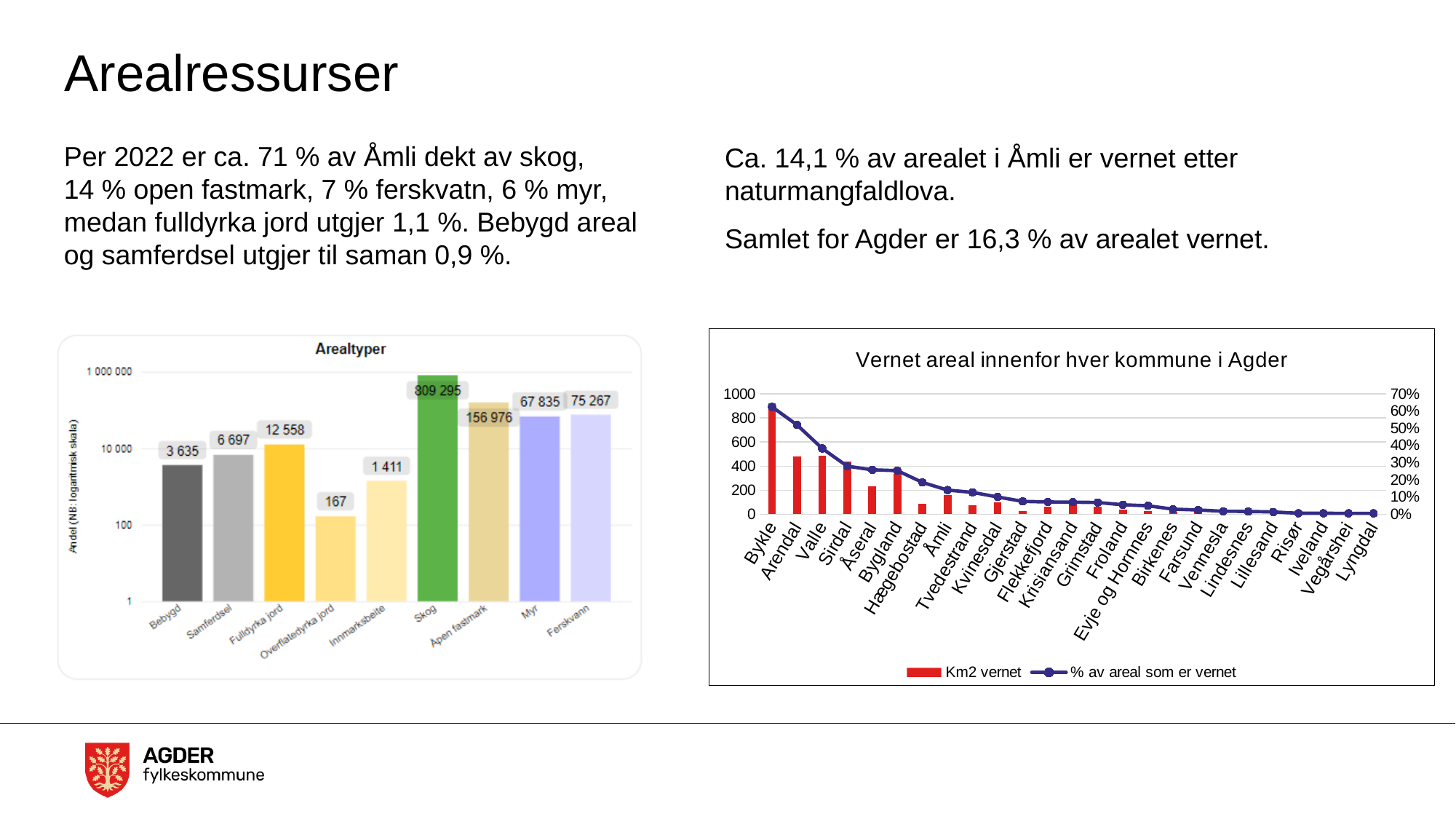
In the Arealtyper chart, what is the value for Skog? 809 295 In the chart 'Vernet areal innenfor hver kommune i Agder', which municipality has the highest Km2 vernet? Bykle In the chart 'Vernet areal innenfor hver kommune i Agder', is the Km2 vernet value for Bykle greater or less than 800? greater In the Arealtyper chart, which category has the highest value? Skog How many series does the legend list in the chart 'Vernet areal innenfor hver kommune i Agder'? 2 How many municipalities are shown in the chart 'Vernet areal innenfor hver kommune i Agder'? 25 In the Arealtyper chart, what is the difference between Ferskvann and Myr? 7 432 In the Arealtyper chart, what is the value for Myr? 67 835 How many categories are shown in the Arealtyper chart? 9 In the Arealtyper chart, which category has the lowest value? Overflatedyrka jord In the Arealtyper chart, what is the value for Overflatedyrka jord? 167 In the Arealtyper chart, which is larger, Samferdsel or Bebygd? Samferdsel